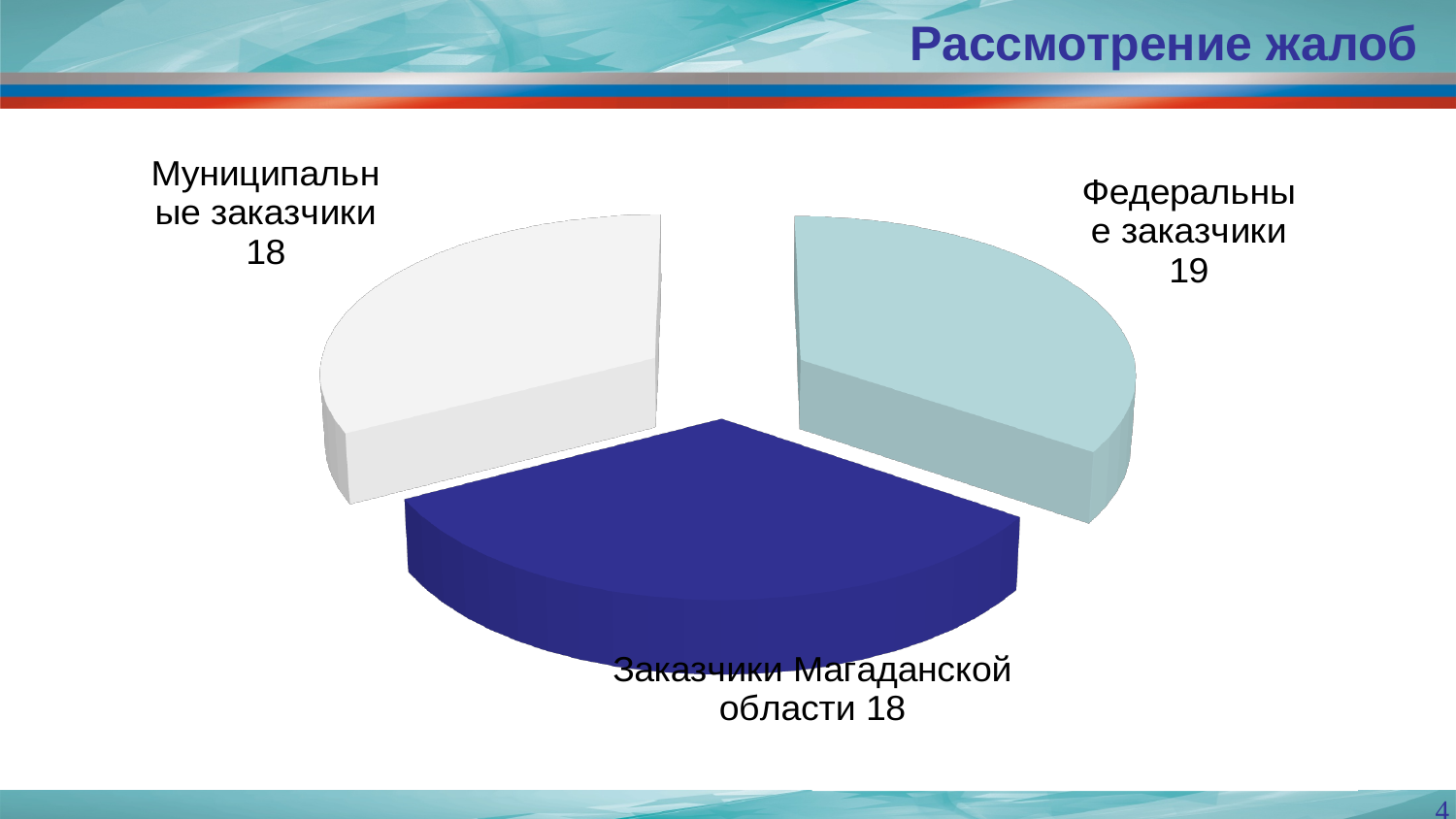
What is the value for Муниципальные заказчики in the pie chart? 18 What kind of chart is shown on the slide? Pie chart How many slices does the pie chart have? 3 What is the value for Заказчики Магаданской области in the pie chart? 18 What is the title of the slide containing the chart? Рассмотрение жалоб What is the total of all slices in the pie chart? 55 Which category has the highest value in the pie chart? Федеральные заказчики Which slice of the pie chart is coloured dark blue? Заказчики Магаданской области Which is larger: the value for Федеральные заказчики or the value for Муниципальные заказчики? Федеральные заказчики What is the value for Федеральные заказчики in the pie chart? 19 What is the difference between the value for Федеральные заказчики and the value for Заказчики Магаданской области? 1